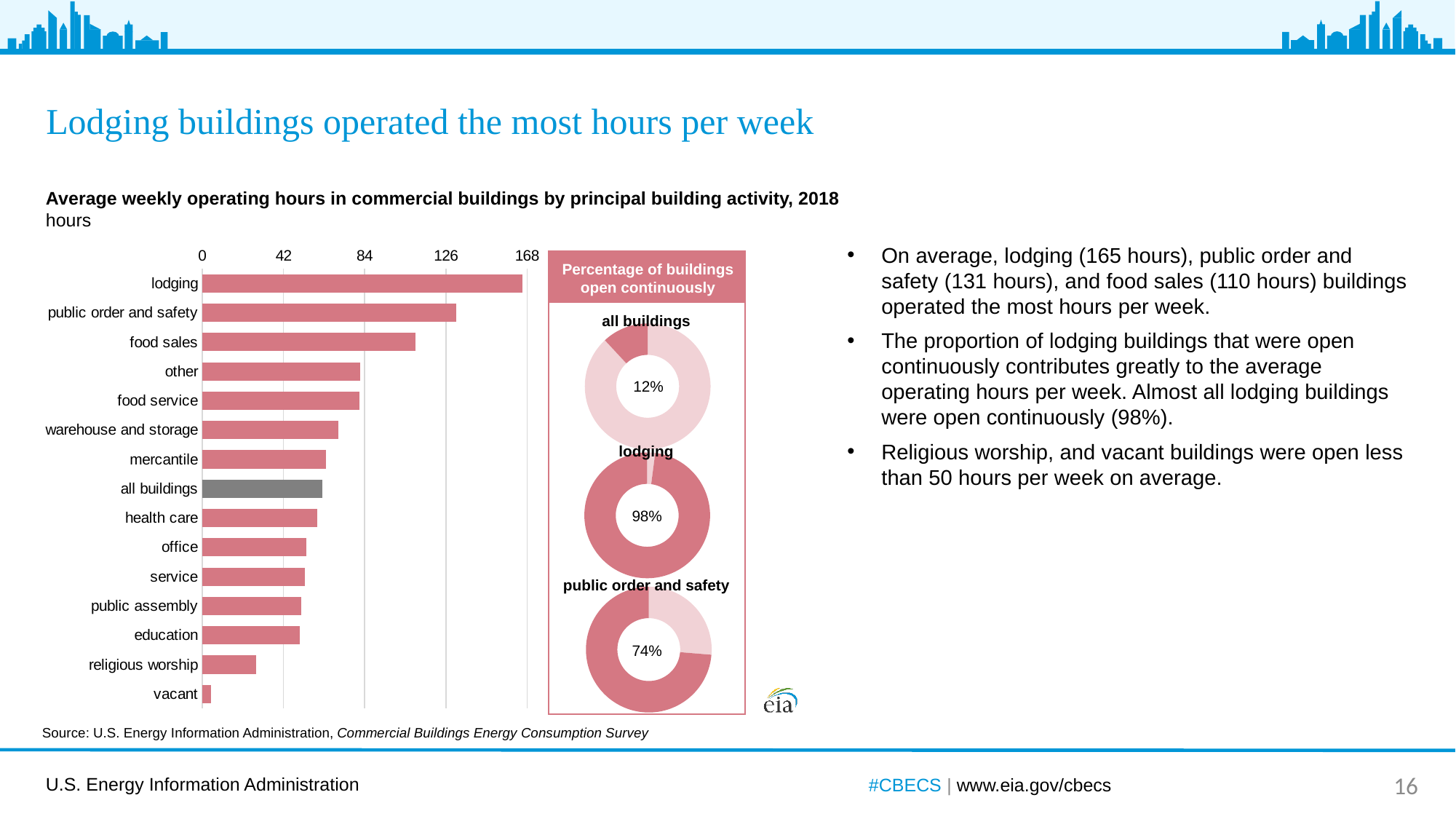
What kind of chart shows average weekly operating hours by principal building activity? bar chart In the bar chart of average weekly operating hours, which bar is coloured grey instead of pink? all buildings In the bar chart of average weekly operating hours, which has the larger value, food sales or mercantile? food sales In the 'Percentage of buildings open continuously' donut charts, what percentage of all buildings are open continuously? 12% In the bar chart of average weekly operating hours, which building activity has the lowest value? vacant In the bar chart of average weekly operating hours, is the value for food sales greater or less than 84? greater In the bar chart of average weekly operating hours, is the value for lodging greater or less than 126? greater In the bar chart of average weekly operating hours, is the value for religious worship greater or less than 42? less In the bar chart of average weekly operating hours, which building activity has the highest value? lodging How many building activity categories are shown in the bar chart of average weekly operating hours? 15 In the 'Percentage of buildings open continuously' donut charts, what is the difference between the lodging percentage and the public order and safety percentage? 24 percentage points In the 'Percentage of buildings open continuously' donut charts, what percentage of lodging buildings are open continuously? 98%